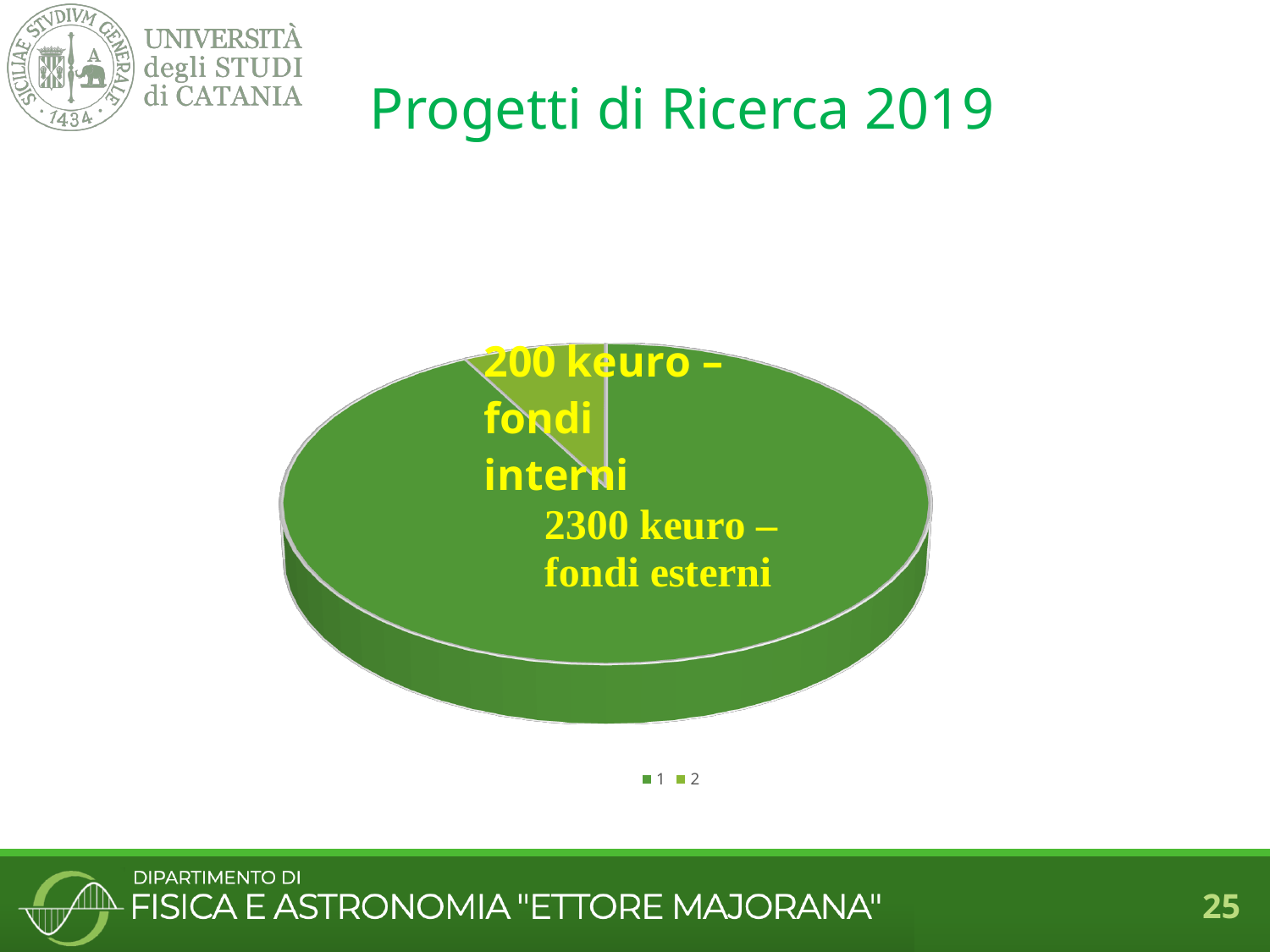
Which slice of the pie chart is the smallest? fondi interni What is the title of the slide containing the pie chart? Progetti di Ricerca 2019 How many slices does the pie chart have? 2 What kind of chart is shown on the slide? Pie chart What value is labelled for fondi interni in the pie chart? 200 keuro What share of the pie chart total do fondi interni represent? 8% How many entries does the legend of the pie chart list? 2 What share of the pie chart total do fondi esterni represent? 92% Which slice of the pie chart is the largest? fondi esterni What is the difference between fondi esterni and fondi interni in the pie chart? 2100 keuro What value is labelled for fondi esterni in the pie chart? 2300 keuro Which is larger in the pie chart, fondi interni or fondi esterni? fondi esterni